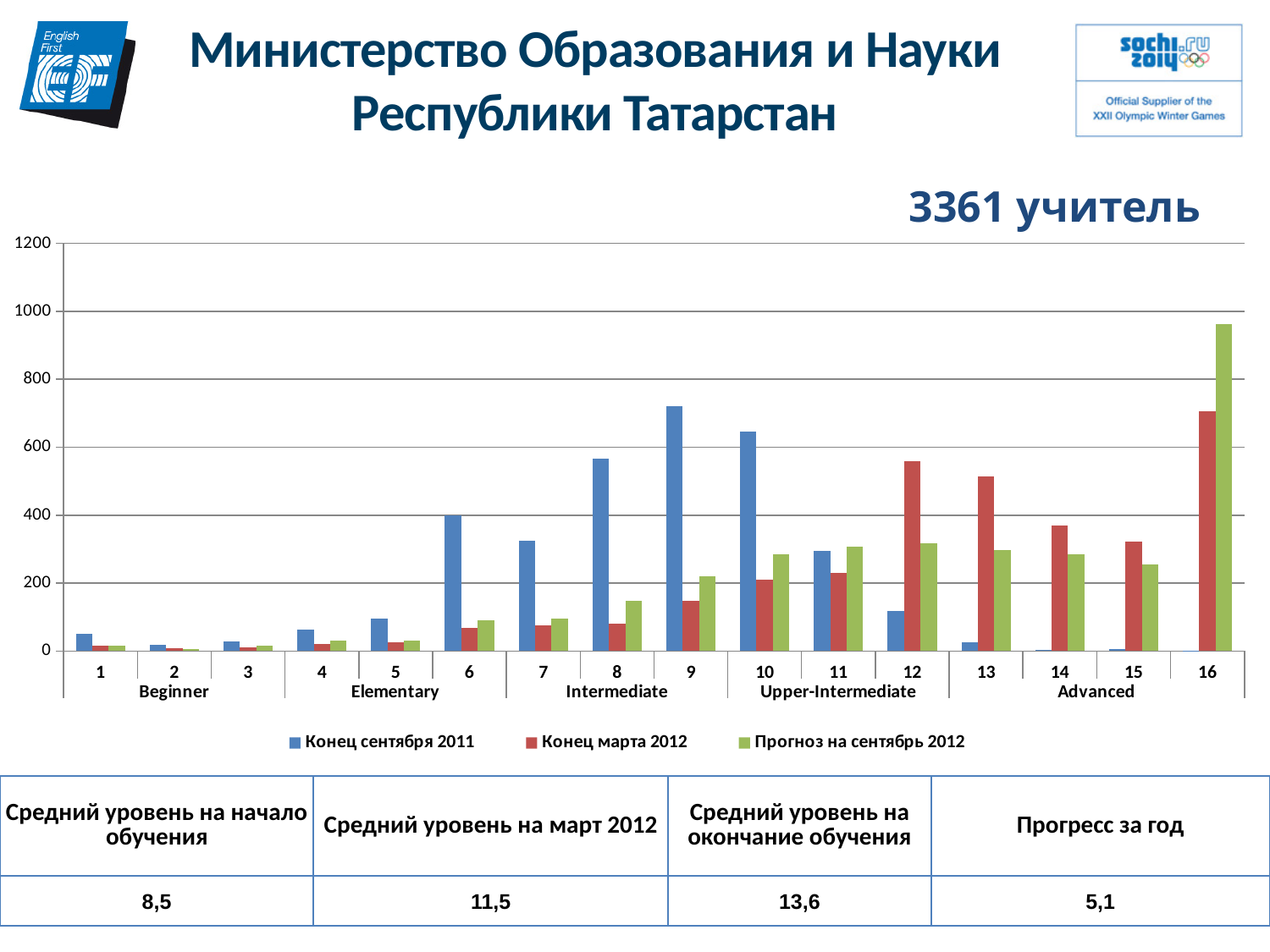
How many numbered levels are shown along the x axis of the chart? 16 What heading is shown above the chart? 3361 учитель At level 12, which series has the larger value: 'Конец сентября 2011' or 'Конец марта 2012'? Конец марта 2012 How many series does the chart legend list? 3 At which level is the 'Конец сентября 2011' series highest? 9 Is the value for 'Прогноз на сентябрь 2012' at level 16 greater or less than 800? greater At level 8, which series has the larger value: 'Конец сентября 2011' or 'Прогноз на сентябрь 2012'? Конец сентября 2011 At which level is the 'Прогноз на сентябрь 2012' series highest? 16 Is the value for 'Конец сентября 2011' at level 9 greater or less than 600? greater At which level is the 'Конец марта 2012' series highest? 16 What kind of chart is shown on the slide? bar chart Is the value for 'Конец марта 2012' at level 12 greater or less than 400? greater